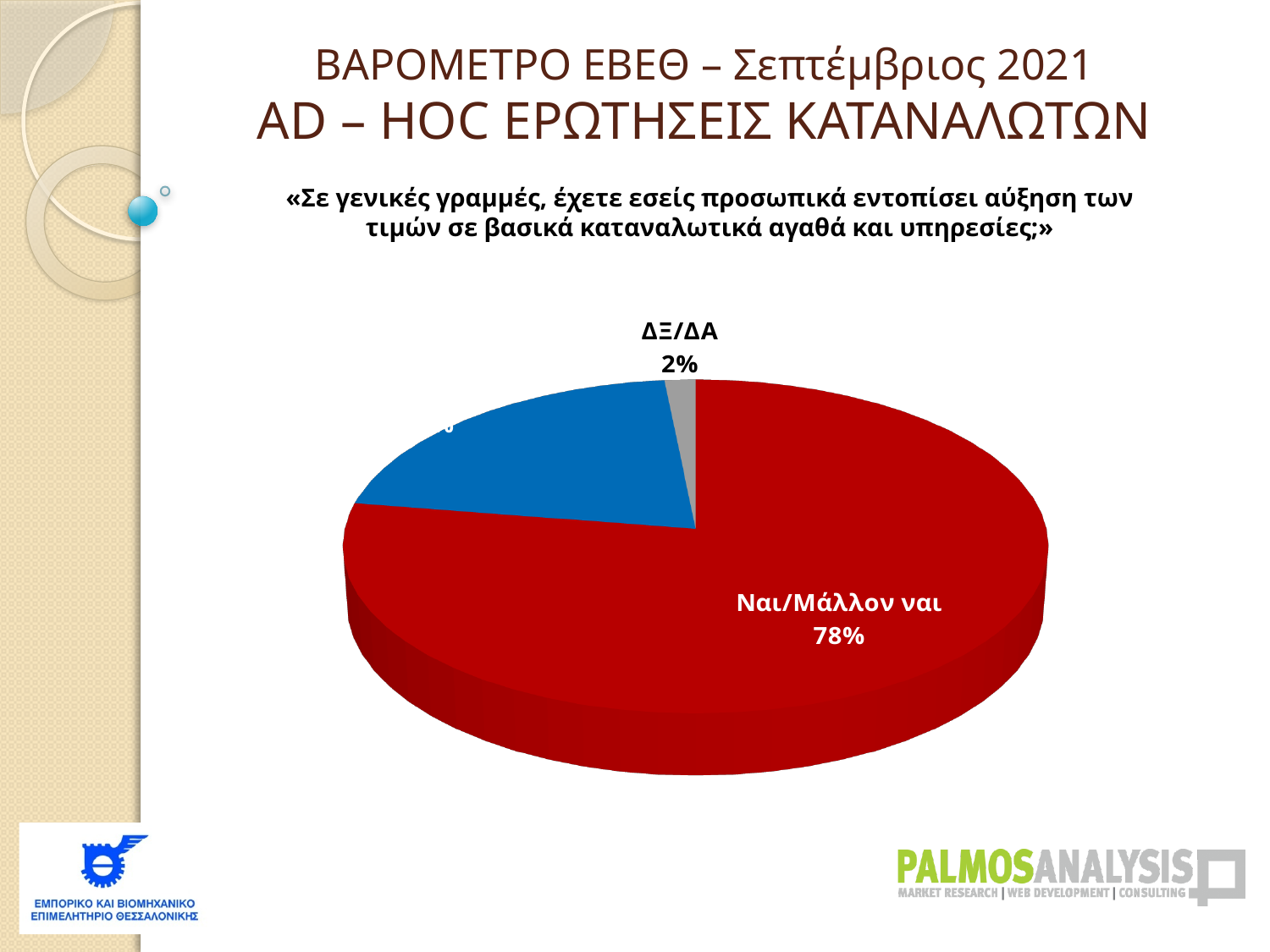
What colour is the "ΔΞ/ΔΑ" slice of the pie? grey What percentage of respondents answered "ΔΞ/ΔΑ"? 2% How many slices does the pie chart have? 3 What colour is the "Ναι/Μάλλον ναι" slice of the pie? red What kind of chart is shown on the slide? pie chart What is the difference in percentage points between the "Ναι/Μάλλον ναι" slice and the "ΔΞ/ΔΑ" slice? 76 percentage points Which response has the largest share of the pie? Ναι/Μάλλον ναι Which response has the smallest share of the pie? ΔΞ/ΔΑ Which is larger, the share for "Ναι/Μάλλον ναι" or the share for "ΔΞ/ΔΑ"? Ναι/Μάλλον ναι What percentage of respondents answered "Ναι/Μάλλον ναι"? 78%